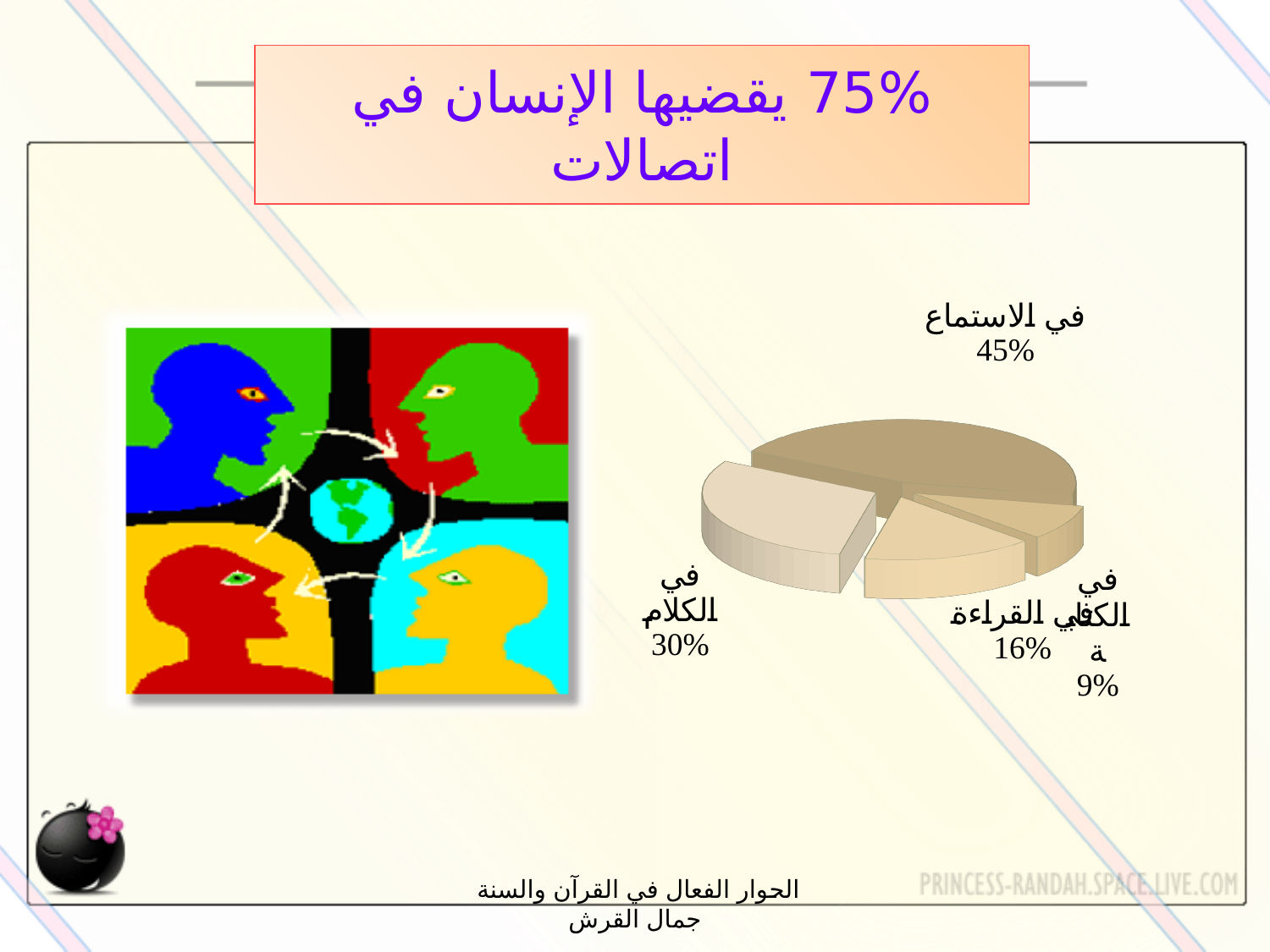
Which slice of the pie chart is the smallest? في الكتابة What is the difference between the percentages for في القراءة and في الكتابة? 7% What percentage does the pie chart show for في الكتابة (writing)? 9% What percentage does the pie chart show for في الاستماع (listening)? 45% What percentage does the pie chart show for في الكلام (speaking)? 30% What percentage does the pie chart show for في القراءة (reading)? 16% Which is larger in the pie chart, في القراءة or في الكتابة? في القراءة What is the difference between the percentages for في الاستماع and في الكلام? 15% How many slices does the pie chart have? 4 What is the combined share of في الاستماع and في الكلام in the pie chart? 75% What kind of chart is shown on the slide? pie chart Which slice of the pie chart is the largest? في الاستماع